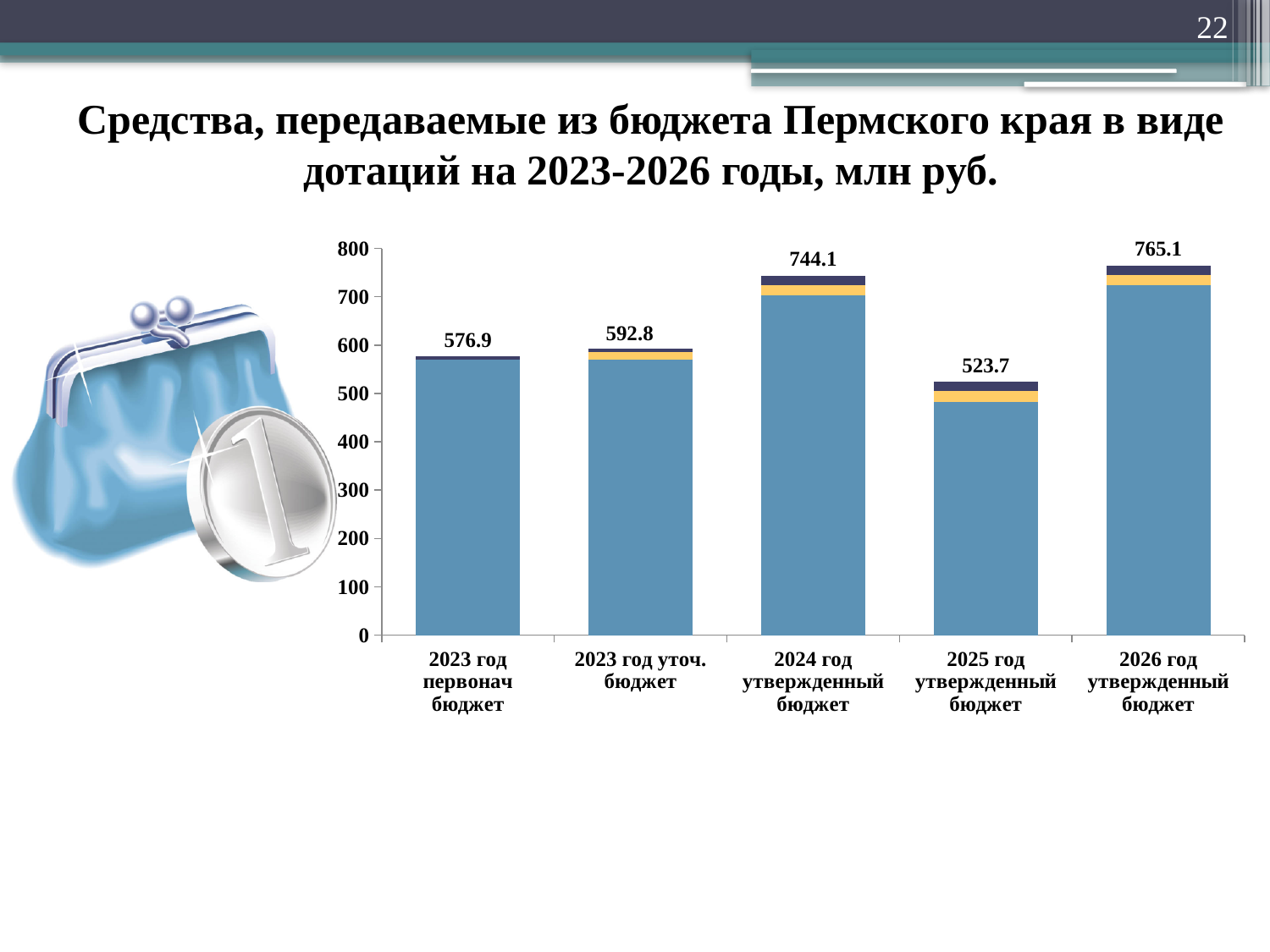
How many categories are shown on the x axis? 5 What is the total value shown for the 2025 год утвержденный бюджет bar? 523.7 What is the total value shown for the 2023 год первонач бюджет bar? 576.9 Which category has the highest total value? 2026 год утвержденный бюджет Which category has the lowest total value? 2025 год утвержденный бюджет Which is larger, the total for 2024 год утвержденный бюджет or for 2026 год утвержденный бюджет? 2026 год утвержденный бюджет What unit of measurement is stated in the chart title? млн руб. What is the difference between the totals for 2026 год утвержденный бюджет and 2025 год утвержденный бюджет? 241.4 Is the total for 2025 год утвержденный бюджет greater or less than 600? less What kind of chart is shown on the slide? stacked bar chart What is the total value shown for the 2024 год утвержденный бюджет bar? 744.1 What is the difference between the totals for 2023 год уточ. бюджет and 2023 год первонач бюджет? 15.9